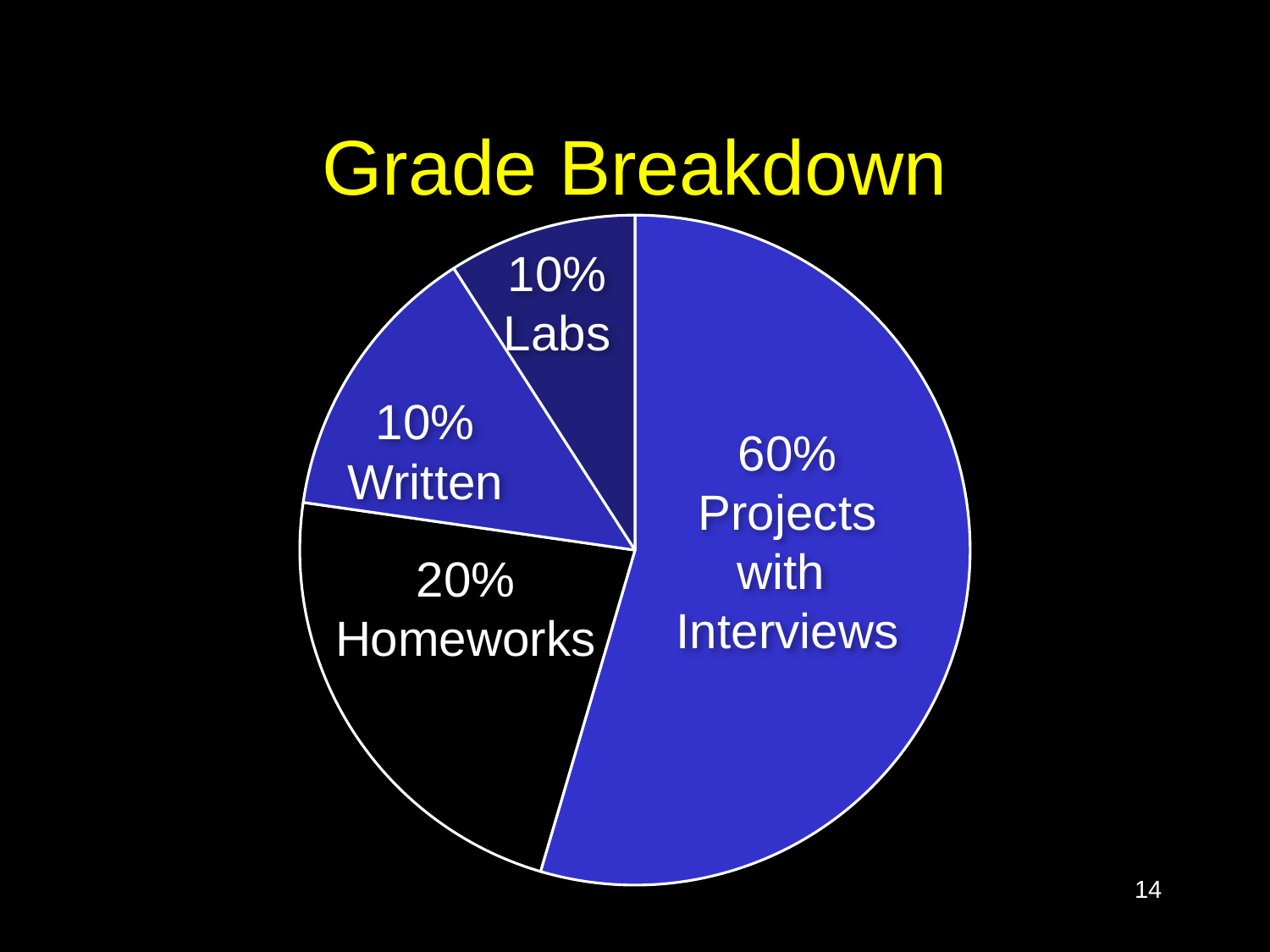
What is the title of the chart? Grade Breakdown How many slices does the pie chart have? 4 What is the difference between the Projects with Interviews share and the Homeworks share? 40% What kind of chart is shown on the slide? Pie chart Which is larger, the Homeworks share or the Labs share? Homeworks What share of the grade comes from Projects with Interviews? 60% What is the combined share of Labs and Written? 20% What share of the grade comes from Written? 10% What share of the grade comes from Labs? 10% Which category has the largest share of the grade? Projects with Interviews Is the share for Projects with Interviews greater or less than 50%? greater